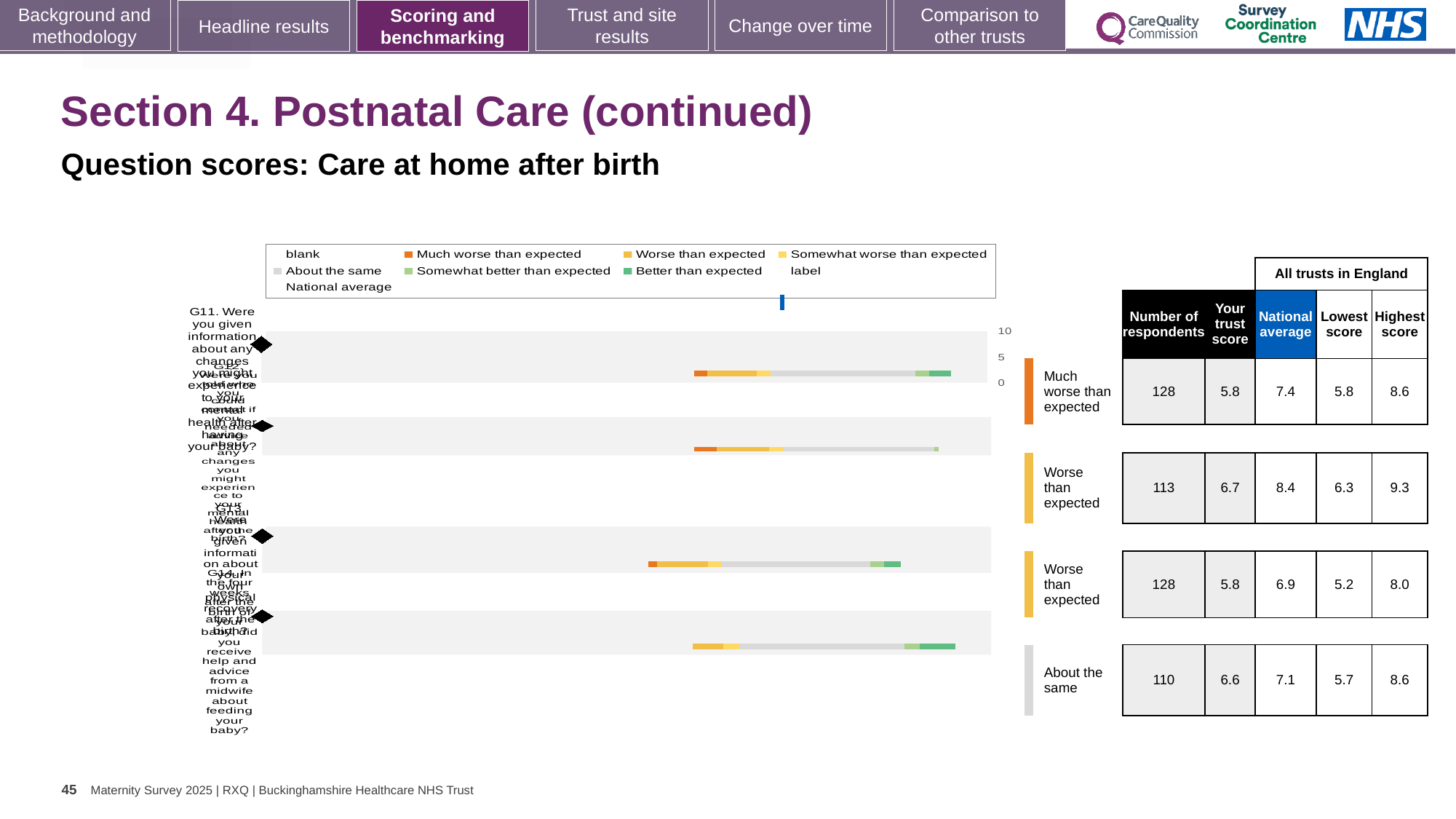
In the chart legend, what colour represents 'Much worse than expected'? orange In the table, which row has the highest national average? the second row (Worse than expected), 8.4 In the table, what is the national average for the first row, rated 'Much worse than expected'? 7.4 In the table, what is the number of respondents for the first row, rated 'Much worse than expected'? 128 In the table, for the fourth row rated 'About the same', which is larger: 'Your trust score' or the national average? National average In the table, what is the highest score for the second row, rated 'Worse than expected'? 9.3 In the table, what is 'Your trust score' for the second row, rated 'Worse than expected'? 6.7 What kind of chart is shown on the slide? bar chart In the table, what is the difference between the national average and 'Your trust score' for the first row? 1.6 How many bars (question rows) does the chart contain? 4 In the table, what is the lowest score for the third row? 5.2 In the table, what is the number of respondents for the fourth row, rated 'About the same'? 110